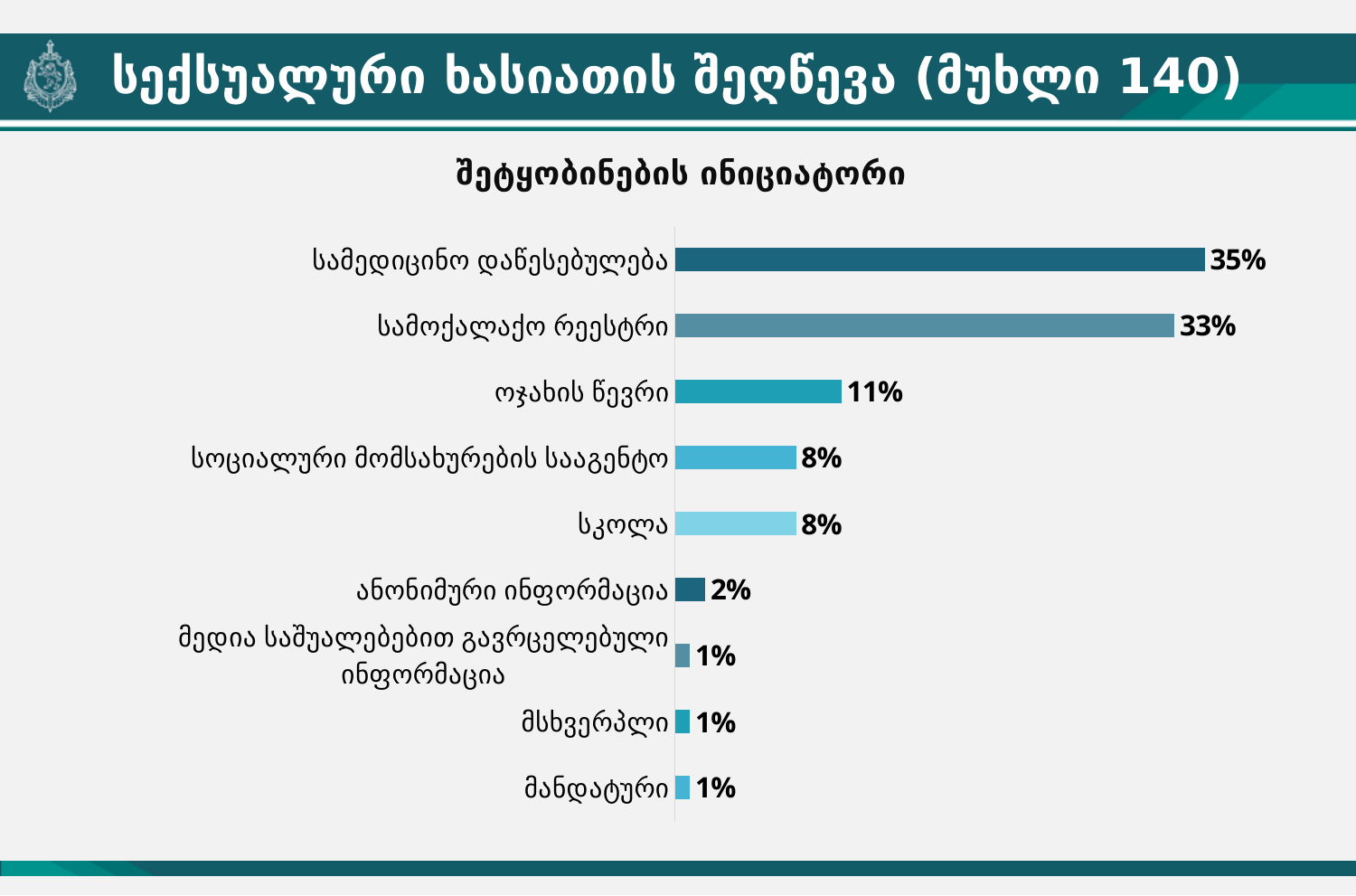
How many categories are shown in the chart? 9 What is the title of the chart? შეტყობინების ინიციატორი Which is larger, the value for სამოქალაქო რეესტრი or the value for ოჯახის წევრი? სამოქალაქო რეესტრი Which category has the highest value? სამედიცინო დაწესებულება What is the value for მსხვერპლი? 1% What is the difference between the values for სამედიცინო დაწესებულება and სამოქალაქო რეესტრი? 2% What is the difference between the values for ოჯახის წევრი and სკოლა? 3% What is the value for სკოლა? 8% What is the value for ანონიმური ინფორმაცია? 2% What is the value for ოჯახის წევრი? 11% What is the value for სამედიცინო დაწესებულება? 35% What kind of chart is shown on the slide? bar chart